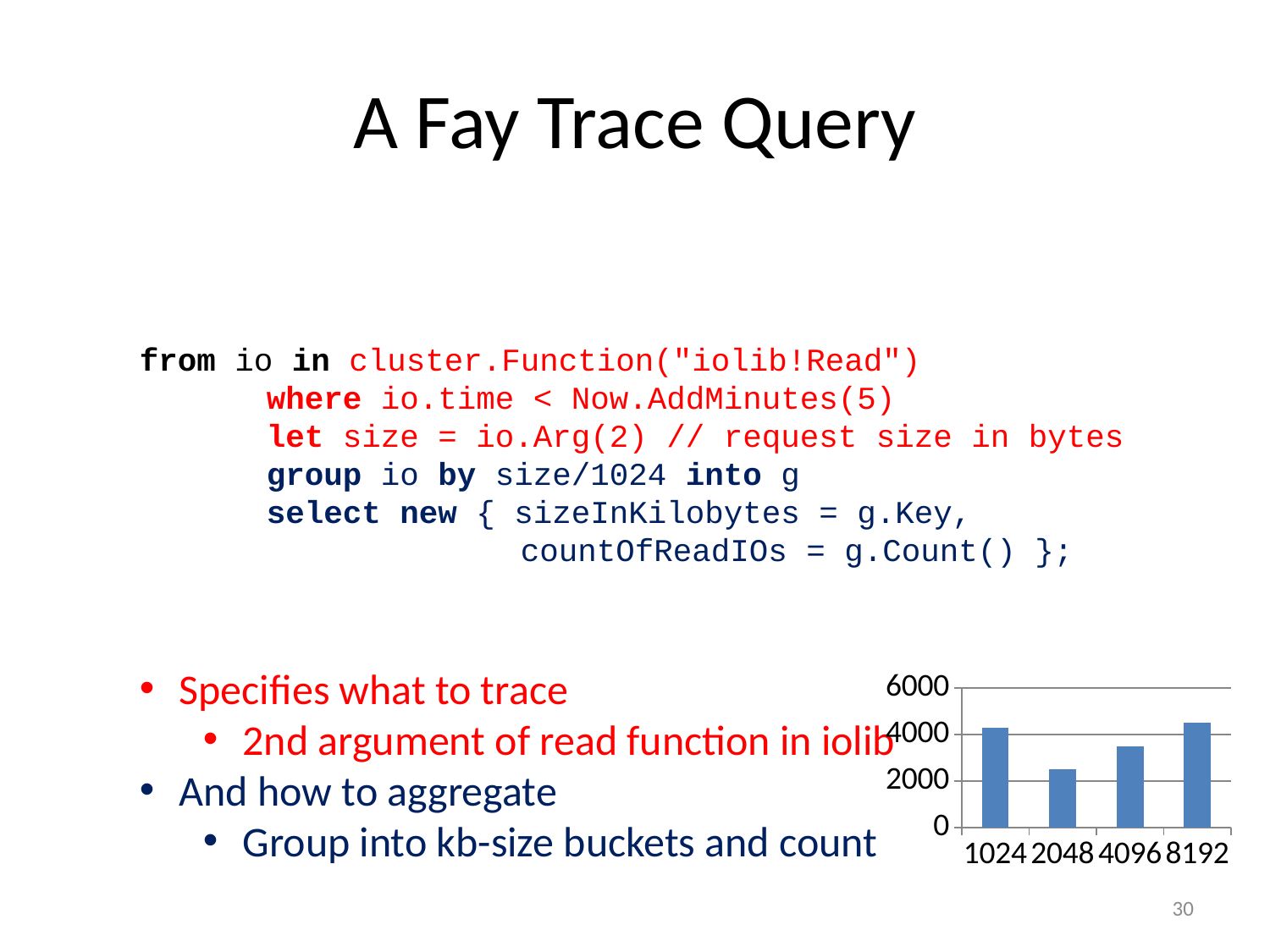
What kind of chart is shown at the bottom right of the slide? bar chart Is the value for 8192 greater or less than 4000? greater How many categories are shown on the x axis of the bar chart? 4 What is the label of the first category on the x axis of the chart? 1024 Which is larger, the value for 1024 or the value for 2048? 1024 Which category has the lowest bar in the chart? 2048 Is the value for 2048 greater or less than 4000? less What is the highest tick value shown on the y axis of the chart? 6000 Is the value for 2048 greater or less than 2000? greater Which is larger, the value for 2048 or the value for 4096? 4096